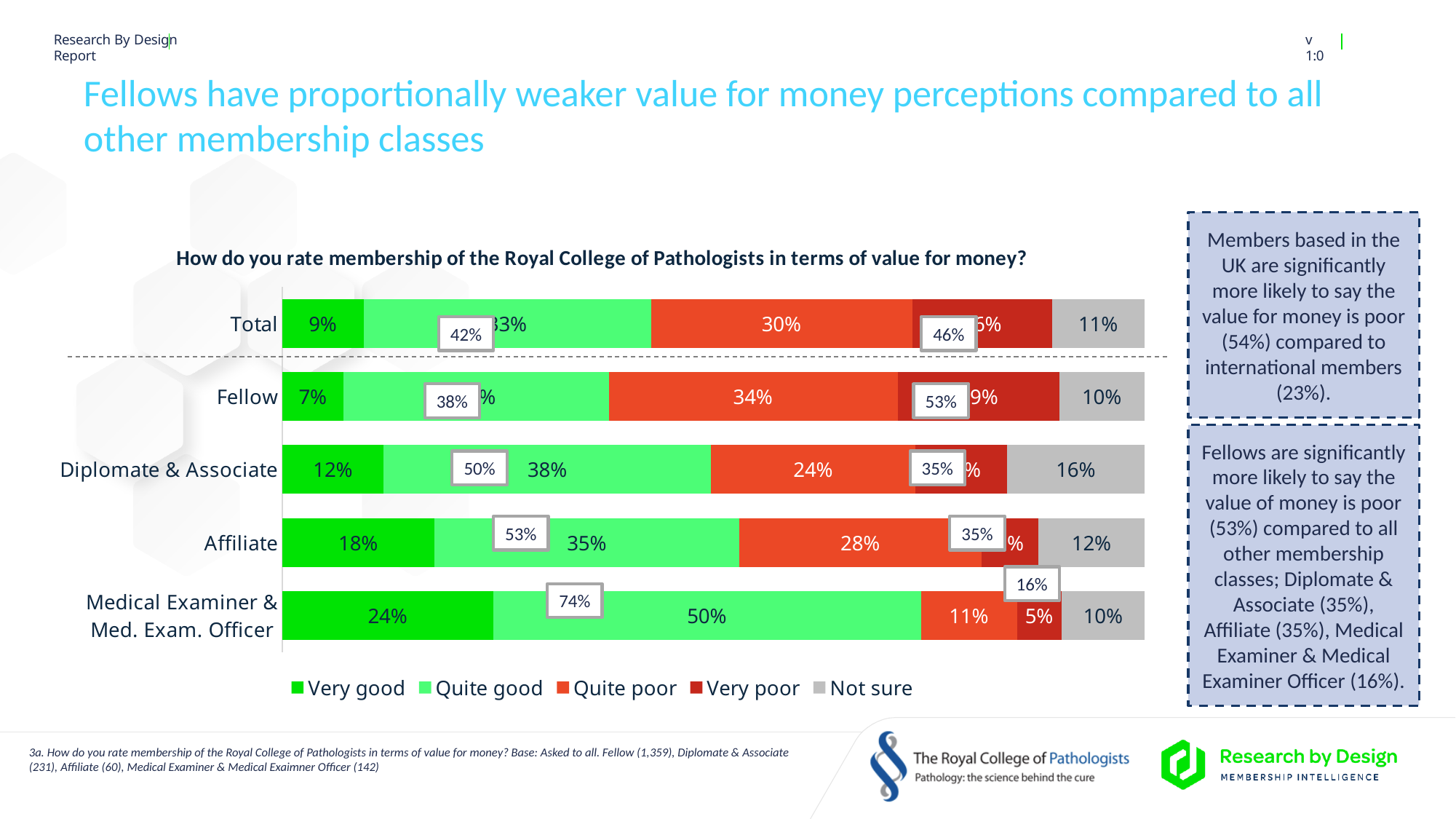
Which category has the lowest 'Very good' value? Fellow What is the 'Quite poor' value for Fellow? 34% What is the difference in 'Very good' values between Medical Examiner & Med. Exam. Officer and Fellow? 17 percentage points How many membership categories are plotted on the chart? 5 What is the 'Very good' value for Medical Examiner & Med. Exam. Officer? 24% Which category has the highest 'Very good' value? Medical Examiner & Med. Exam. Officer What kind of chart is shown on the slide? Stacked bar chart What is the 'Not sure' value for Diplomate & Associate? 16% Which has the larger 'Quite poor' value, Total or Affiliate? Total What is the 'Quite good' value for Affiliate? 35% How many series does the legend list? 5 What question does the chart title say respondents were asked? How do you rate membership of the Royal College of Pathologists in terms of value for money?